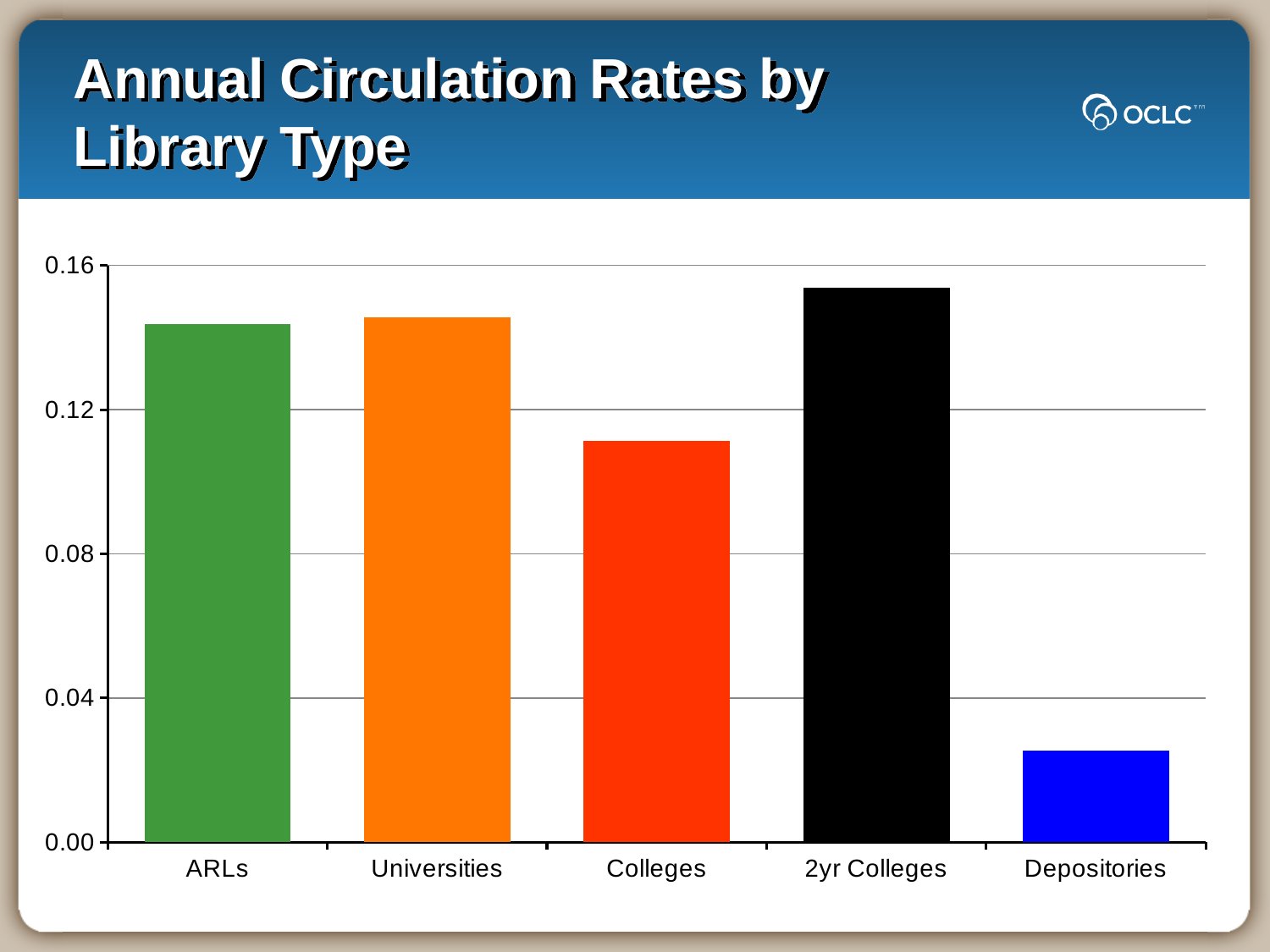
Is the value for ARLs greater or less than 0.12? greater Is the value for Depositories greater or less than 0.04? less What colour is the bar for Depositories? blue What kind of chart is shown on the slide? bar chart Is the value for 2yr Colleges greater or less than 0.12? greater Which has a higher annual circulation rate, Colleges or Depositories? Colleges Which has a higher annual circulation rate, Universities or Colleges? Universities Which library type has the lowest annual circulation rate? Depositories Which library type has the highest annual circulation rate? 2yr Colleges How many library types are shown on the chart? 5